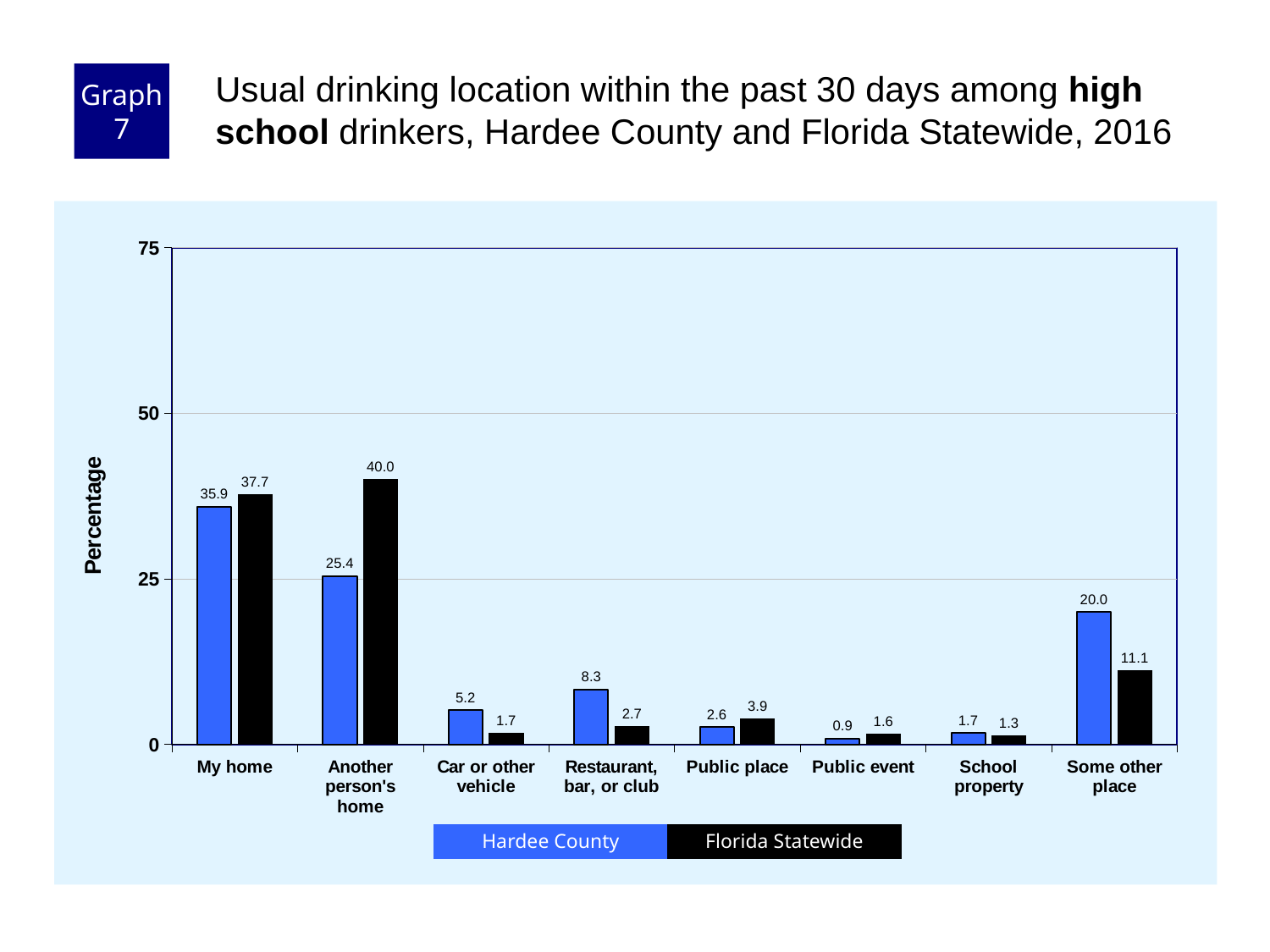
What is the label on the y axis? Percentage Which category has the highest Hardee County value? My home What is the Florida Statewide value for Another person's home? 40.0 Which is larger for Restaurant, bar, or club: Hardee County or Florida Statewide? Hardee County What is the Hardee County value for Some other place? 20.0 What is the Hardee County value for My home? 35.9 How many categories are shown on the x axis? 8 What is the difference between the Florida Statewide and Hardee County values for Another person's home? 14.6 Is the Florida Statewide value for My home greater or less than 25? greater How many series does the legend list? 2 Which category has the lowest Florida Statewide value? School property What kind of chart is shown? bar chart